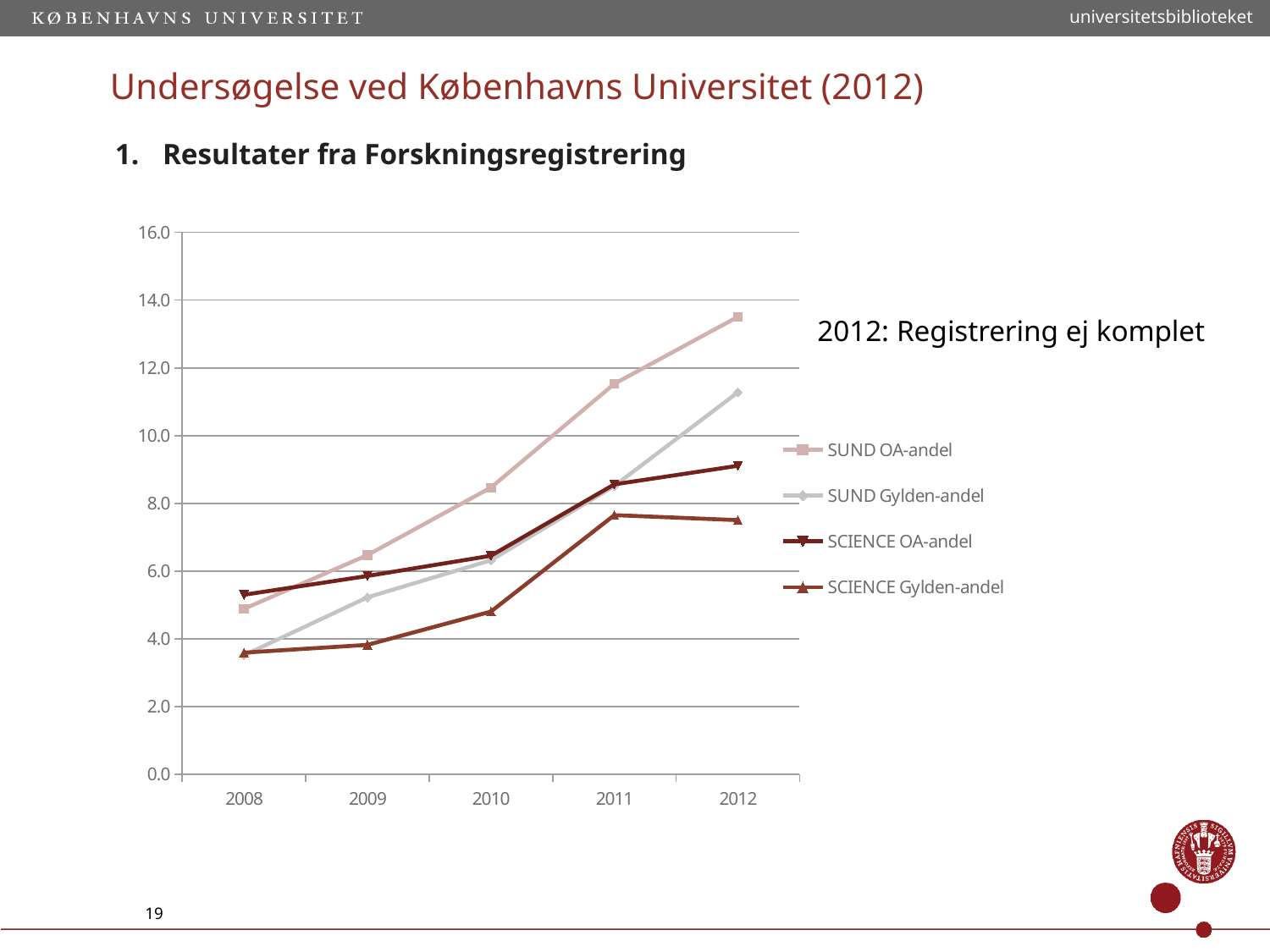
What note is written next to the chart about 2012? 2012: Registrering ej komplet What kind of chart is shown on the slide? Line chart Is the value for SCIENCE Gylden-andel in 2008 greater or less than 4.0? less Which series has the highest value in 2012? SUND OA-andel Which series is shown with triangle markers pointing upward in the legend? SCIENCE Gylden-andel Which series has the lowest value in 2012? SCIENCE Gylden-andel In 2010, which is larger: SUND OA-andel or SCIENCE OA-andel? SUND OA-andel Is the value for SUND OA-andel in 2012 greater or less than 12.0? greater How many years are plotted along the x axis? 5 Does the SUND OA-andel series rise or fall from 2008 to 2012? Rises How many series does the legend list? 4 Is the value for SUND OA-andel in 2011 greater or less than 10.0? greater